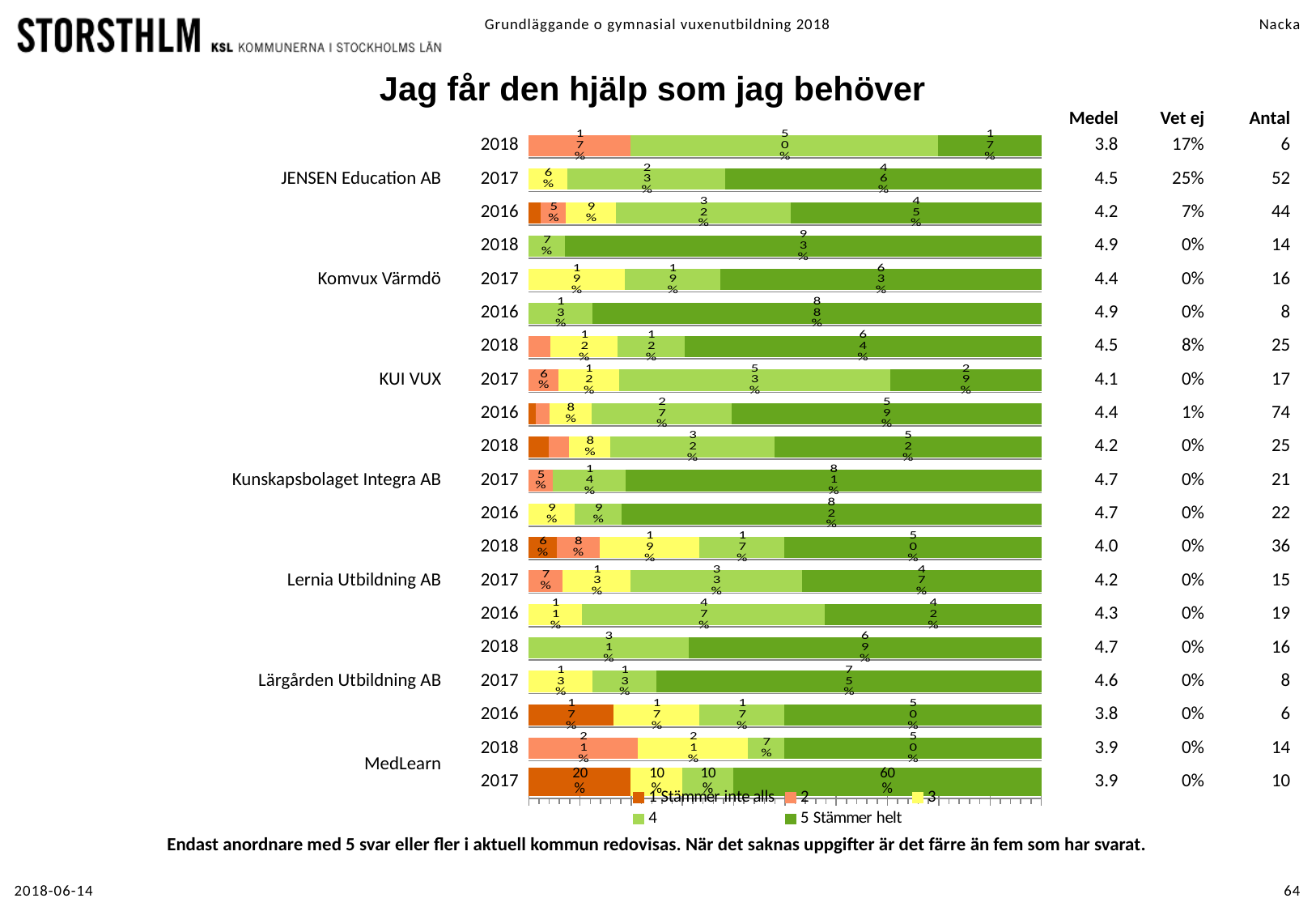
What is the share of '5 Stämmer helt' for Lernia Utbildning AB in 2018? 50% What is the share of '1 Stämmer inte alls' for MedLearn in 2017? 20% What is the share of '5 Stämmer helt' for Komvux Värmdö in 2018? 93% How many series does the chart legend list? 5 What is the share of '4' for Lärgården Utbildning AB in 2018? 31% How many bars are plotted in the chart? 20 What kind of chart is shown on the slide? Stacked bar chart Which has the larger '5 Stämmer helt' share: Komvux Värmdö 2018 or KUI VUX 2018? Komvux Värmdö 2018 For MedLearn in 2017, how many percentage points larger is the '5 Stämmer helt' share than the '1 Stämmer inte alls' share? 40 percentage points Which bar has the highest share of '5 Stämmer helt'? Komvux Värmdö 2018 What is the title of the chart? Jag får den hjälp som jag behöver What is the share of '4' for JENSEN Education AB in 2018? 50%